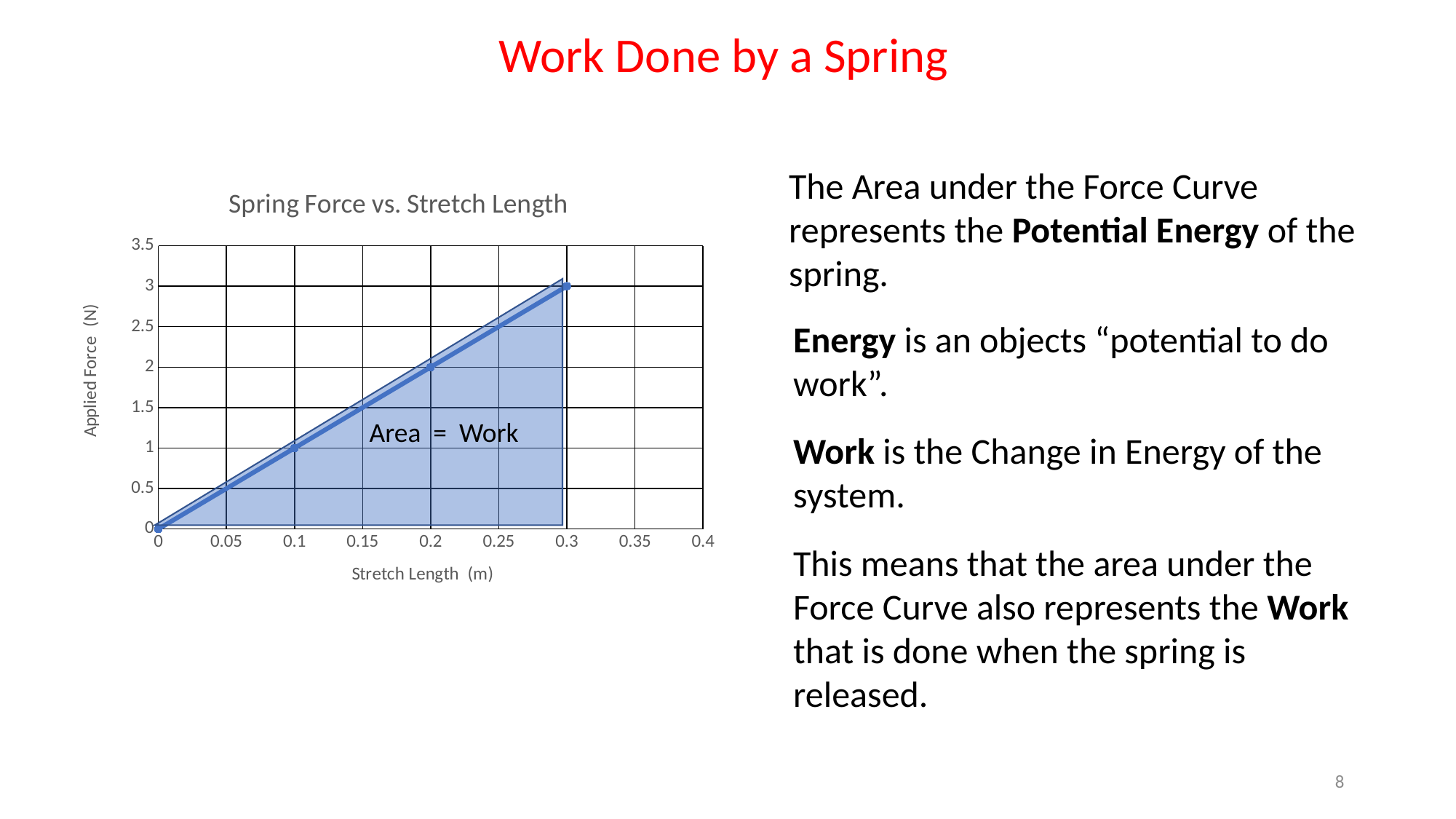
What is the applied force at a stretch length of 0.3 m? 3 What is the applied force at a stretch length of 0.2 m? 2 What is the applied force at a stretch length of 0.1 m? 1 Which has a larger applied force: a stretch length of 0.25 m or 0.15 m? 0.25 m What is the title of the chart? Spring Force vs. Stretch Length At which stretch length is the applied force highest? 0.3 What does the label inside the shaded area under the line say? Area = Work Does the applied force rise or fall as stretch length increases? rise At which stretch length is the applied force lowest? 0 What is the difference in applied force between stretch lengths of 0.3 m and 0.1 m? 2 What kind of chart is shown on the slide? line chart How many data points are plotted on the chart? 7